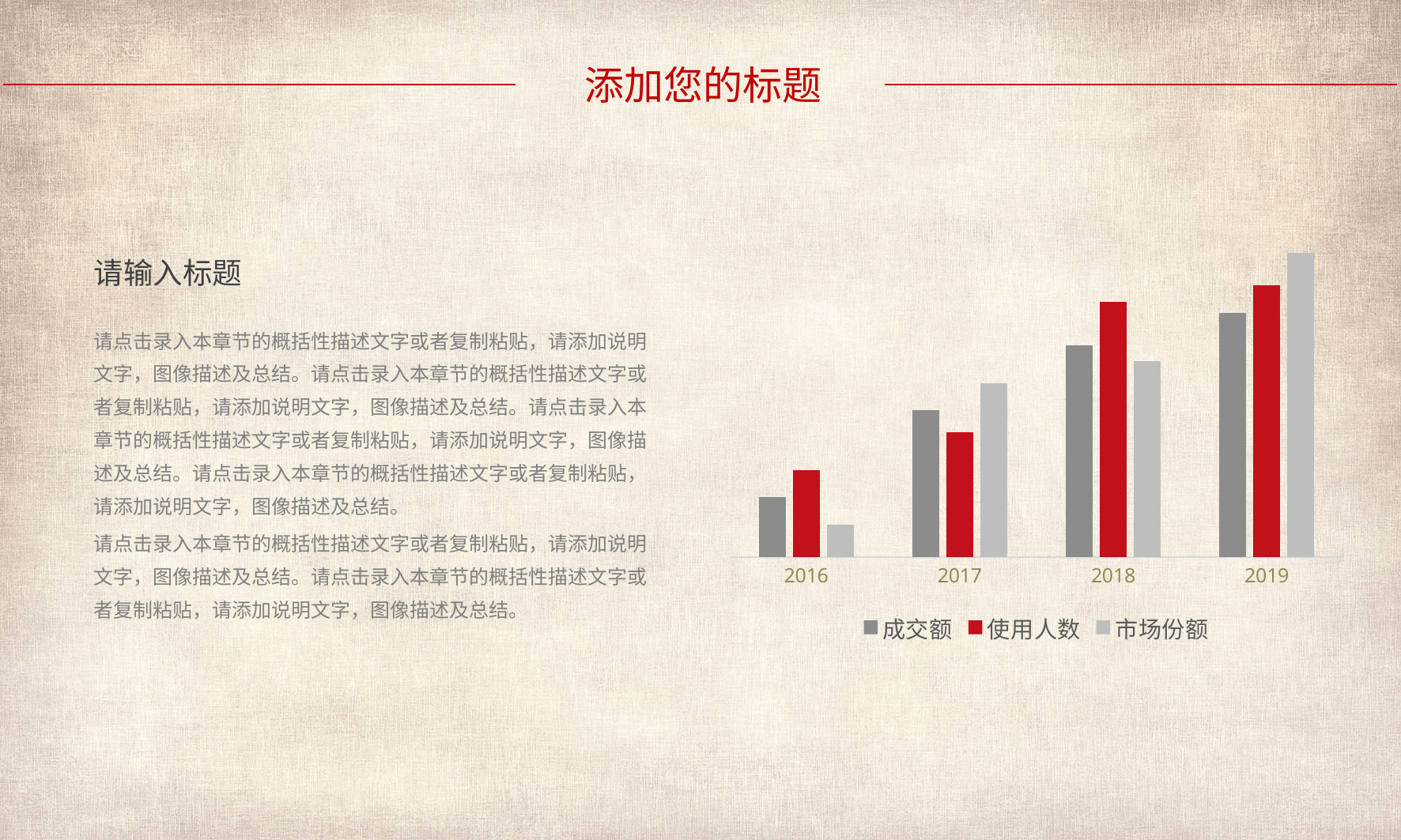
How many years are shown on the x axis of the chart? 4 Which year has the lowest value for 使用人数? 2016 In 2016, which is larger: 成交额 or 使用人数? 使用人数 Which year has the lowest value for 市场份额? 2016 What kind of chart is shown on the slide? bar chart How many series does the chart's legend list? 3 Do the values for 成交额 rise or fall from 2016 to 2019? rise Which year has the highest value for 成交额? 2019 Which series has the highest bar in 2018? 使用人数 Which series is shown in red in the chart? 使用人数 In 2019, which is larger: 使用人数 or 市场份额? 市场份额 In 2018, which is larger: 成交额 or 市场份额? 成交额